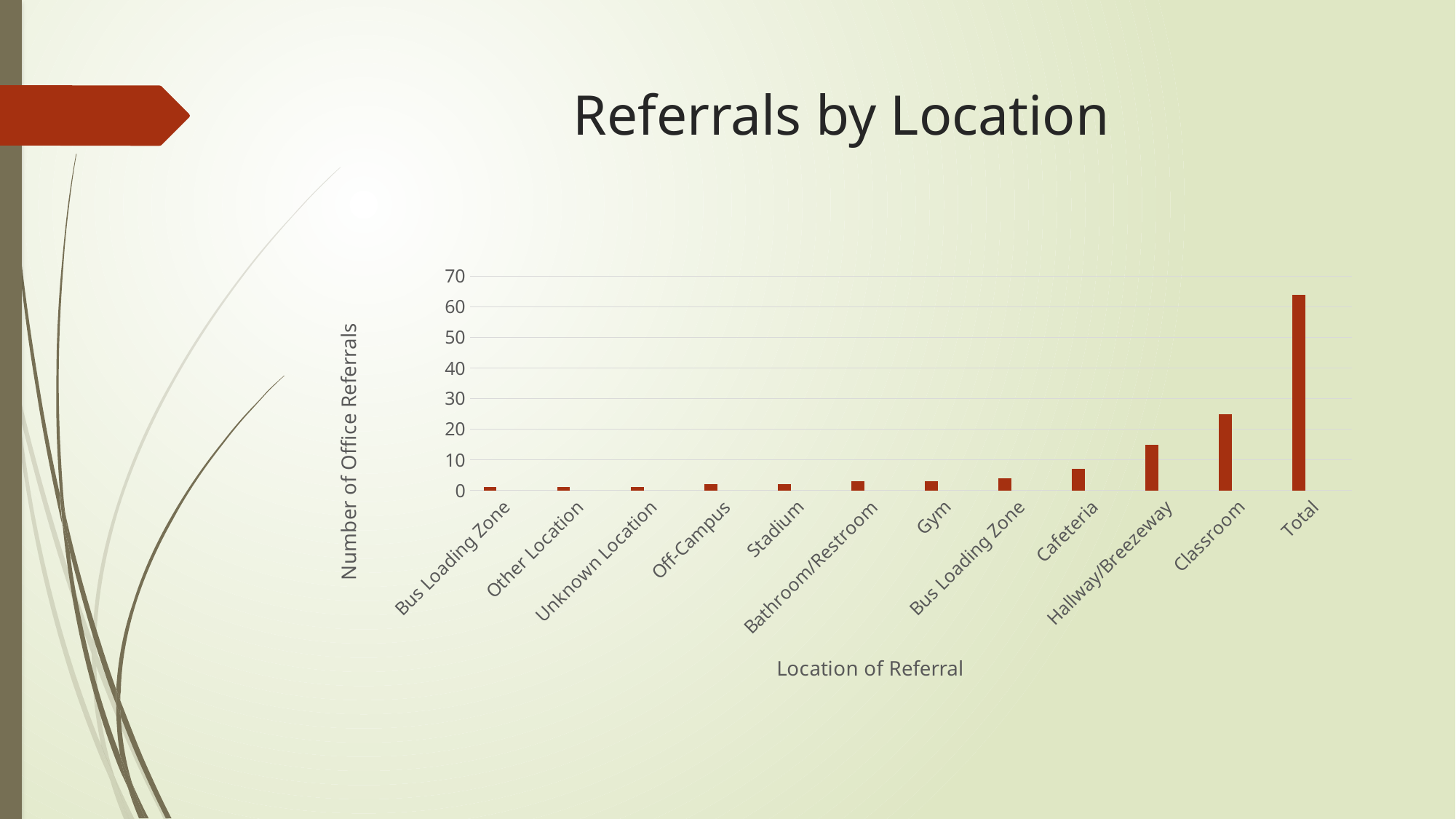
Is the value for Total greater or less than 60? greater Do the bar values generally rise or fall from left to right along the x axis? Rise What is the title of the chart? Referrals by Location Is the value for Classroom greater or less than 30? less Is the value for Classroom greater or less than 20? greater How many categories are shown along the x axis of the chart? 12 What is the label on the vertical axis of the chart? Number of Office Referrals Excluding Total, which location has the highest number of office referrals? Classroom Which has more office referrals, Classroom or Hallway/Breezeway? Classroom What kind of chart is shown on the slide? Bar chart Which category has the highest bar in the chart? Total